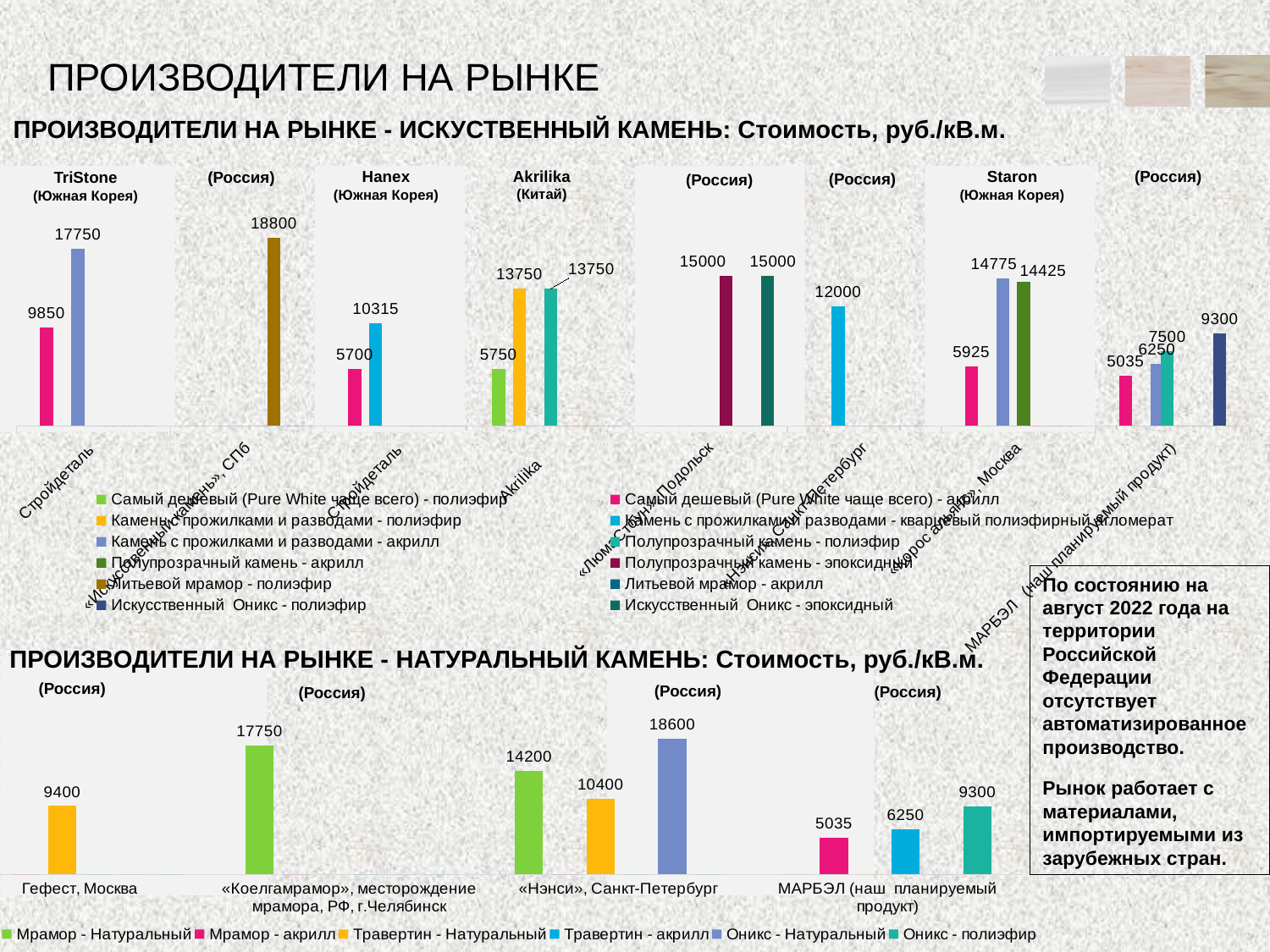
On the bottom chart (НАТУРАЛЬНЫЙ КАМЕНЬ), which category has the highest value? «Нэнси», Санкт-Петербург On the top chart (ИСКУСТВЕННЫЙ КАМЕНЬ), what is the highest value shown for TriStone (Южная Корея)? 17750 On the bottom chart (НАТУРАЛЬНЫЙ КАМЕНЬ), how many categories are shown on the x axis? 4 On the bottom chart (НАТУРАЛЬНЫЙ КАМЕНЬ), what is the value for Гефест, Москва? 9400 On the bottom chart (НАТУРАЛЬНЫЙ КАМЕНЬ), what is the value of Мрамор - акрилл for МАРБЭЛ? 5035 On the top chart (ИСКУСТВЕННЫЙ КАМЕНЬ), what is the difference between the two values shown for Hanex (Южная Корея)? 4615 What kind of chart is the bottom chart (НАТУРАЛЬНЫЙ КАМЕНЬ)? Bar chart On the top chart (ИСКУСТВЕННЫЙ КАМЕНЬ), what is the value of Литьевой мрамор - полиэфир for the Russian manufacturer in СПб? 18800 On the bottom chart (НАТУРАЛЬНЫЙ КАМЕНЬ), how many series does the legend list? 6 On the bottom chart (НАТУРАЛЬНЫЙ КАМЕНЬ), what is the difference between Мрамор - Натуральный and Травертин - Натуральный for «Нэнси», Санкт-Петербург? 3800 On the bottom chart (НАТУРАЛЬНЫЙ КАМЕНЬ), what is the value of Оникс - Натуральный for «Нэнси», Санкт-Петербург? 18600 On the top chart (ИСКУСТВЕННЫЙ КАМЕНЬ), which is larger: the lowest value for Hanex (Южная Корея) or the lowest value for Staron (Южная Корея)? Staron (5925)